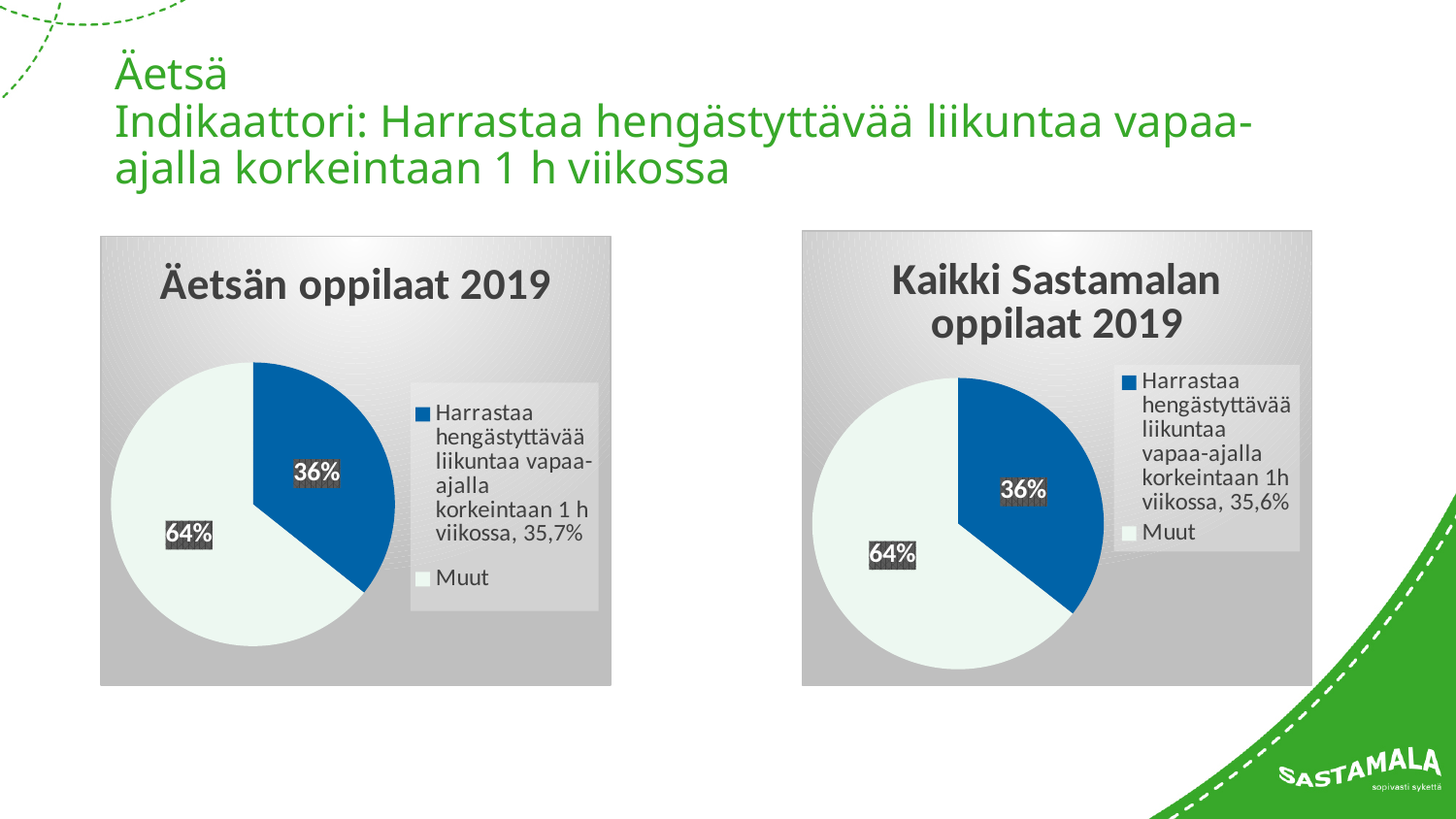
In the "Äetsän oppilaat 2019" chart, what is the difference in percentage points between the "Muut" slice and the blue slice? 28 In the "Äetsän oppilaat 2019" chart, what colour is the "Muut" slice? light green How many entries does the legend of the "Kaikki Sastamalan oppilaat 2019" chart list? 2 In the "Kaikki Sastamalan oppilaat 2019" chart, what share of the pie is labelled "Muut"? 64% How many slices does the "Äetsän oppilaat 2019" pie chart have? 2 In the "Kaikki Sastamalan oppilaat 2019" chart, what exact percentage is given in the legend for the "Harrastaa hengästyttävää liikuntaa" entry? 35,6% In the "Kaikki Sastamalan oppilaat 2019" chart, what percentage is shown on the blue slice? 36% In the "Kaikki Sastamalan oppilaat 2019" chart, which slice is the smallest? Harrastaa hengästyttävää liikuntaa vapaa-ajalla korkeintaan 1h viikossa In the "Äetsän oppilaat 2019" chart, what percentage is shown on the blue slice? 36% In the "Äetsän oppilaat 2019" chart, what share of the pie is labelled "Muut"? 64% In the "Äetsän oppilaat 2019" chart, which slice is the largest? Muut What kind of chart is the "Äetsän oppilaat 2019" chart? pie chart